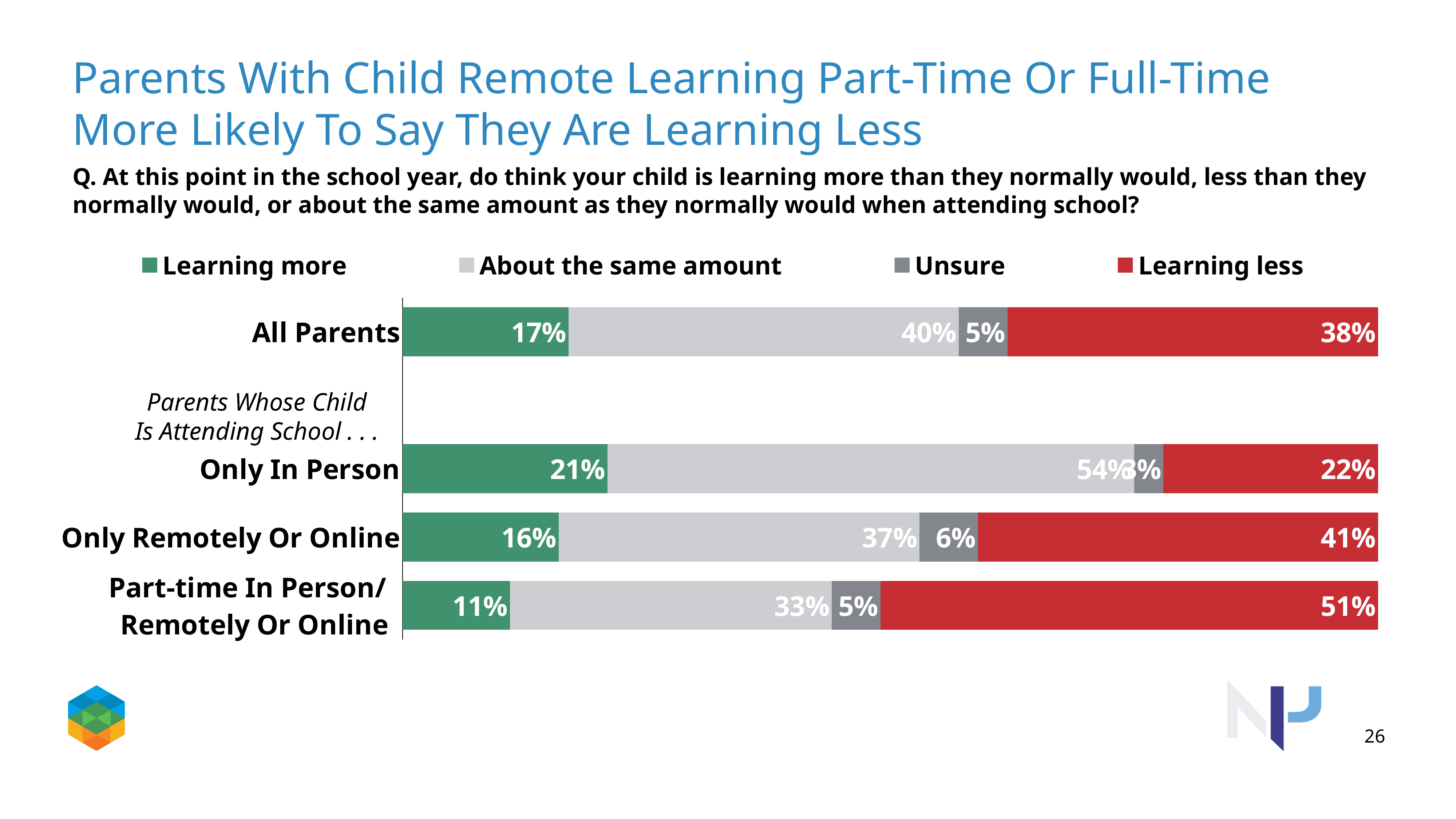
What is the difference between the Learning less percentage for Part-time In Person/Remotely Or Online and for Only In Person? 29% What percentage of parents whose child is attending school Only In Person say their child is learning more? 21% How many parent groups are shown as bars in the chart? 4 Which group has the lowest percentage saying their child is learning more? Part-time In Person/Remotely Or Online What percentage of parents whose child is attending Part-time In Person/Remotely Or Online say their child is learning less? 51% What percentage of parents whose child is attending Only Remotely Or Online are Unsure? 6% What kind of chart is shown on the slide? Stacked bar chart Which group has the highest percentage saying their child is learning less? Part-time In Person/Remotely Or Online How many series does the legend list? 4 Which is larger: the About the same amount percentage for Only In Person or for Only Remotely Or Online? Only In Person Which colour represents Learning less in the chart? Red What percentage of All Parents say their child is learning less? 38%